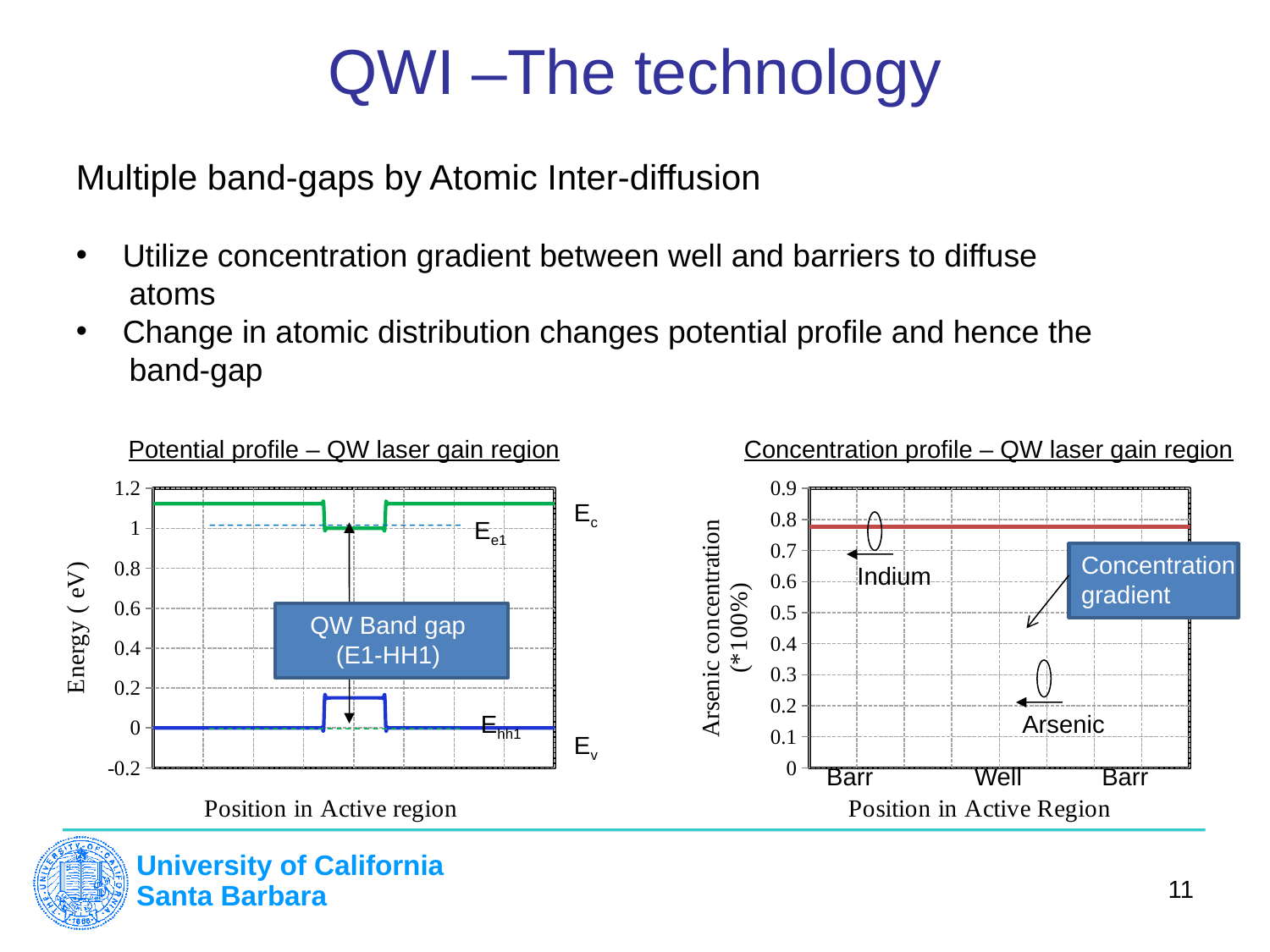
What kind of chart is the 'Concentration profile – QW laser gain region' chart? line chart In the 'Concentration profile – QW laser gain region' chart, how many position labels are shown along the x-axis? 3 In the 'Concentration profile – QW laser gain region' chart, what is the y-axis title? Arsenic concentration (*100%) In the 'Potential profile – QW laser gain region' chart, is the Ev line in the barrier regions greater or less than 0.2? less In the 'Potential profile – QW laser gain region' chart, what is the lowest value shown on the y-axis? -0.2 What kind of chart is the 'Potential profile – QW laser gain region' chart? line chart In the 'Concentration profile – QW laser gain region' chart, is the red Indium line greater or less than 0.7? greater In the 'Potential profile – QW laser gain region' chart, is the Ec line in the barrier regions greater or less than 1? greater In the 'Potential profile – QW laser gain region' chart, which line is higher in energy, Ec or Ev? Ec In the 'Concentration profile – QW laser gain region' chart, what is the highest value shown on the y-axis? 0.9 In the 'Potential profile – QW laser gain region' chart, what is the y-axis title? Energy ( eV) In the 'Potential profile – QW laser gain region' chart, what is the highest value shown on the y-axis? 1.2